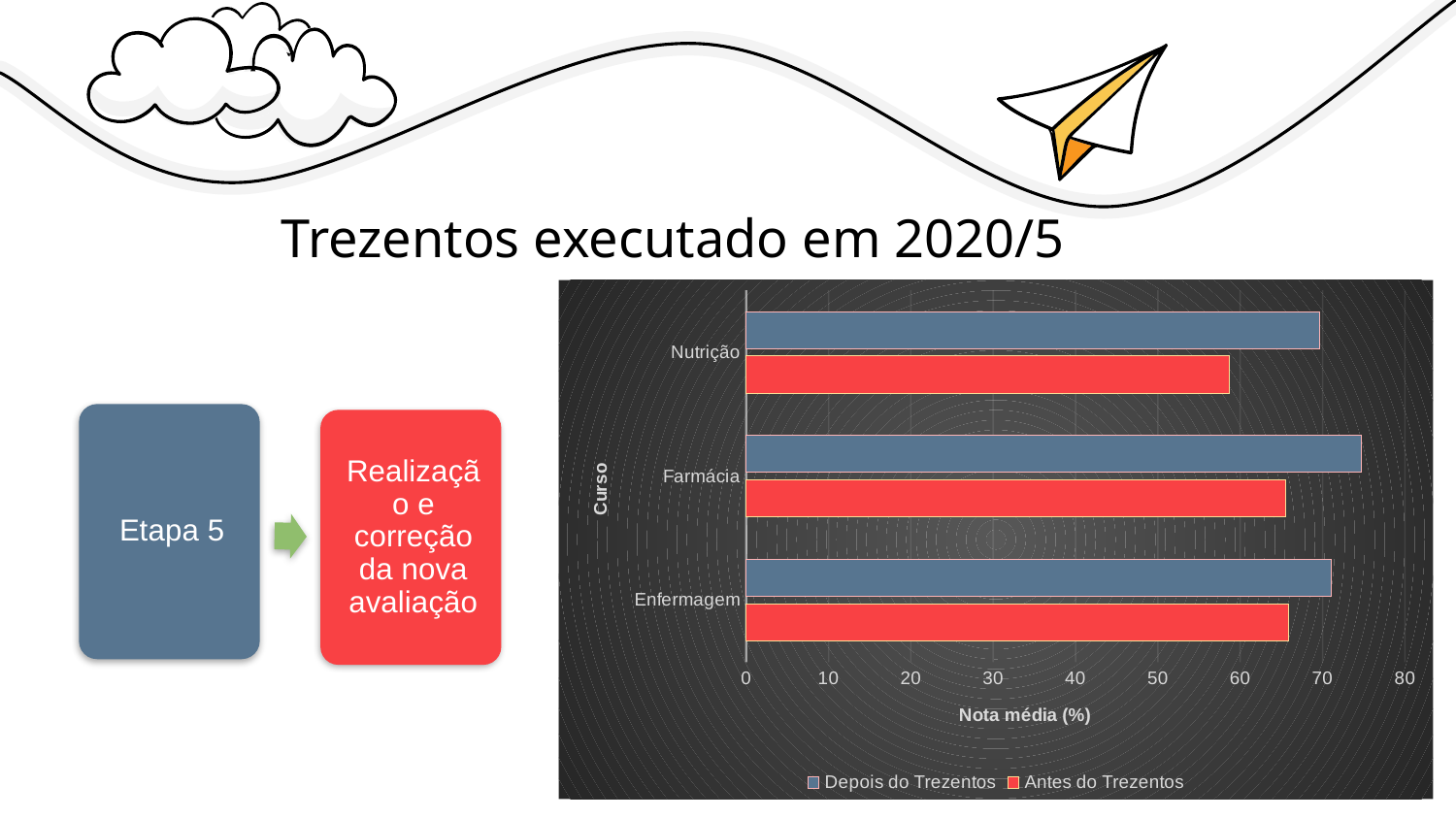
What is the title of the horizontal (x) axis of the chart? Nota média (%) Is the 'Depois do Trezentos' value for Farmácia greater or less than 70? greater What is the title of the vertical (y) axis of the chart? Curso For Farmácia, which is larger: 'Depois do Trezentos' or 'Antes do Trezentos'? Depois do Trezentos Is the 'Antes do Trezentos' value for Enfermagem greater or less than 60? greater Which course has the lowest value for the 'Antes do Trezentos' series? Nutrição How many series does the chart legend list? 2 How many courses (categories) are shown on the chart? 3 Which course has the highest value for the 'Depois do Trezentos' series? Farmácia Is the 'Antes do Trezentos' value for Nutrição greater or less than 70? less For Nutrição, which is larger: 'Depois do Trezentos' or 'Antes do Trezentos'? Depois do Trezentos What kind of chart is shown on the slide? bar chart